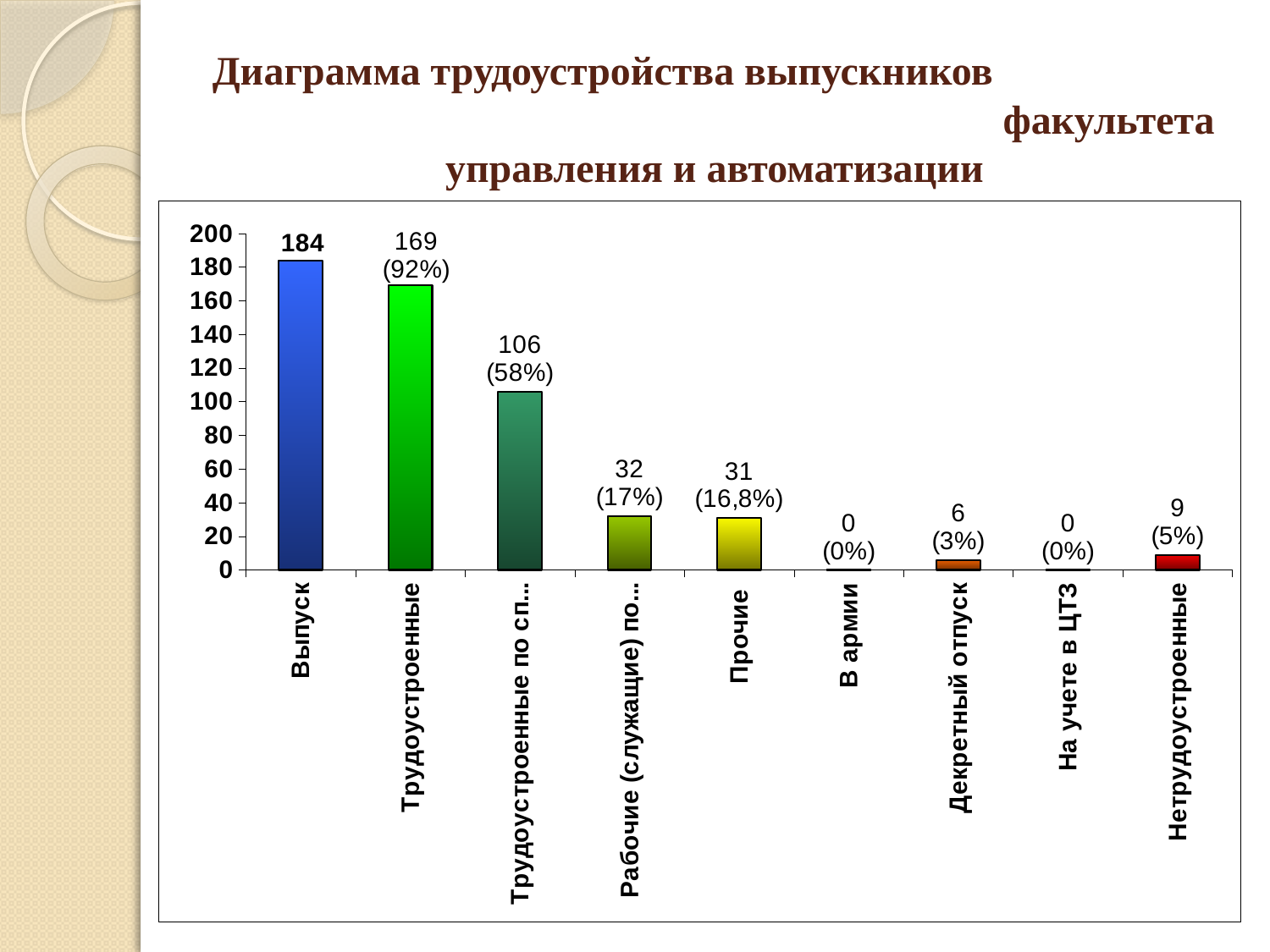
What is the difference between the values for Выпуск and Трудоустроенные? 15 What is the value for Нетрудоустроенные? 9 Which is larger, the value for Декретный отпуск or the value for Нетрудоустроенные? Нетрудоустроенные Which category has the highest value? Выпуск What percentage is shown for Трудоустроенные? 92% What is the value for Выпуск? 184 What kind of chart is shown on the slide? Bar chart What is the value for В армии? 0 How many categories are shown on the x axis? 9 What is the value for Трудоустроенные? 169 What is the value for Декретный отпуск? 6 What is the value for Прочие? 31